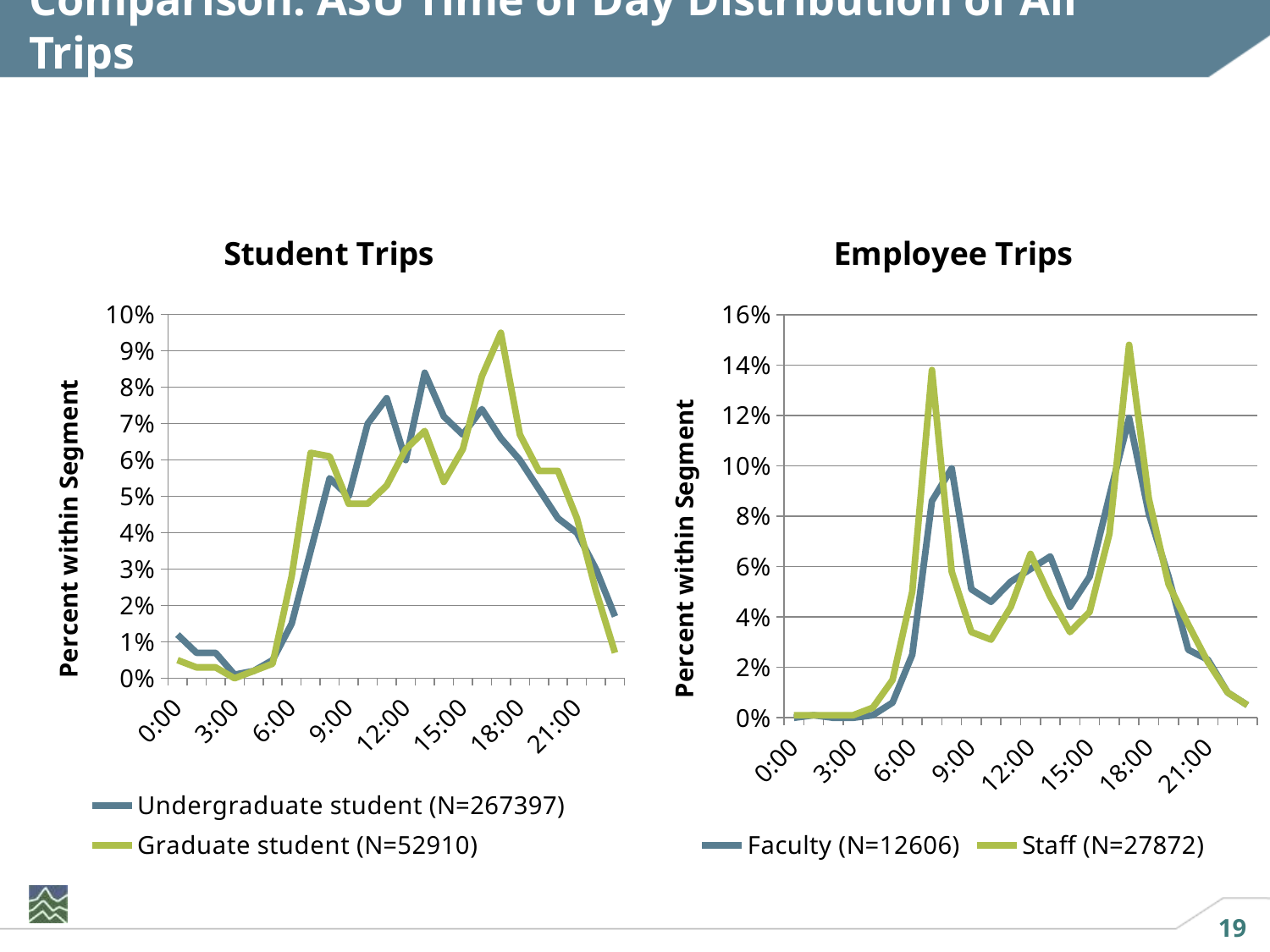
Which two series are listed in the legend of the Employee Trips chart? Faculty (N=12606) and Staff (N=27872) In the Employee Trips chart, is the value for Faculty at 12:00 greater or less than 8%? less In the Employee Trips chart, is the value for Staff at 8:00 greater or less than 12%? less In the Student Trips chart, at 18:00, which series has the higher value, Undergraduate student or Graduate student? Graduate student What kind of chart is the Student Trips chart? line chart How many series does the legend of the Student Trips chart list? 2 In the Employee Trips chart, at 18:00, which series has the higher value, Faculty or Staff? Staff How many series does the legend of the Employee Trips chart list? 2 What is the y-axis title of the Employee Trips chart? Percent within Segment In the Employee Trips chart, is the value for Staff at 18:00 greater or less than 14%? less In the Employee Trips chart, at what time of day does the Staff series reach its highest value? 17:00